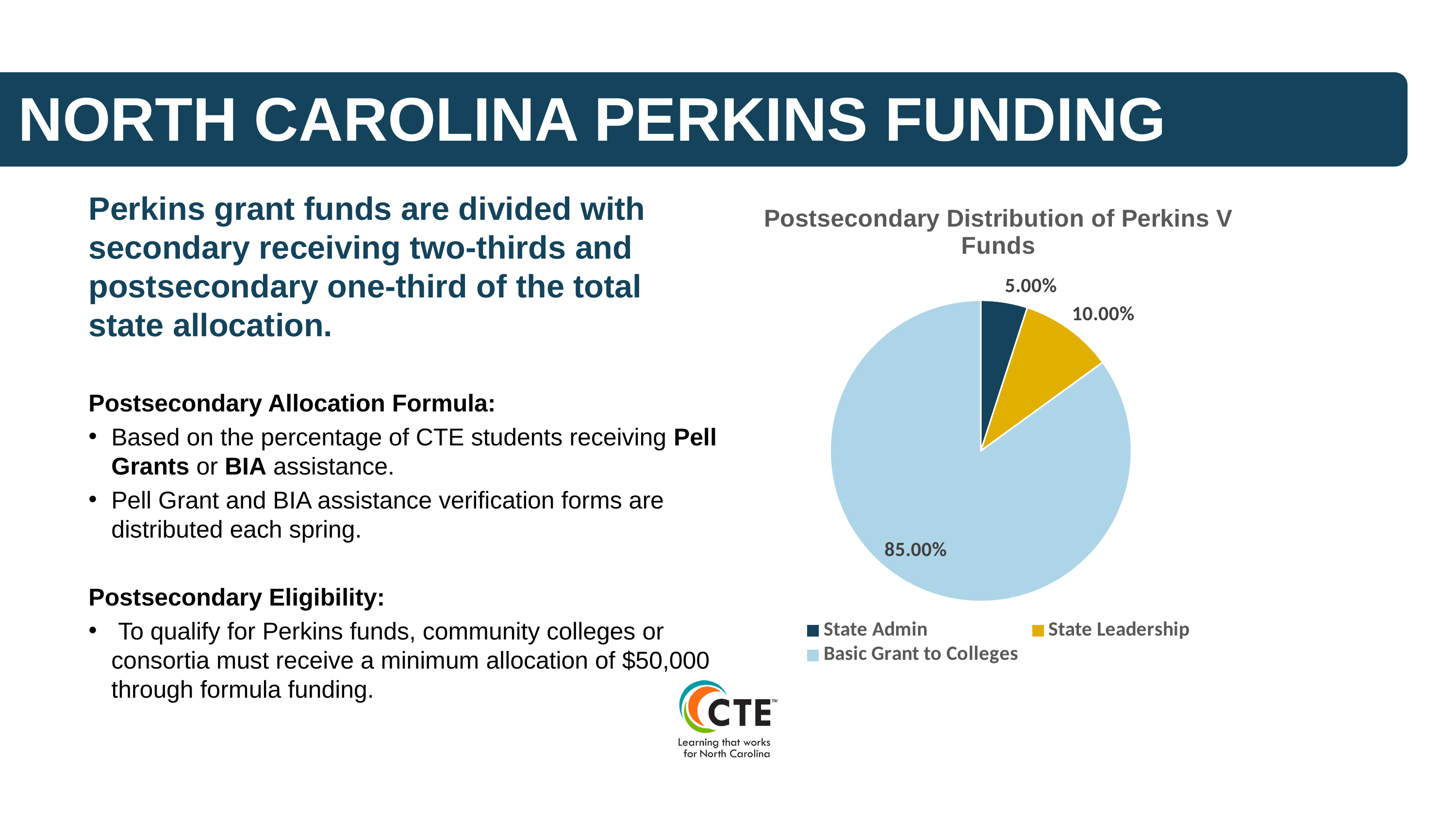
How many slices does the pie chart have? 3 Which is larger, the share for State Leadership or the share for State Admin? State Leadership Which category receives the largest share of Perkins V funds? Basic Grant to Colleges What is the title of the chart? Postsecondary Distribution of Perkins V Funds How many entries does the legend list? 3 What is the difference between the State Leadership share and the State Admin share? 5.00% Which category receives the smallest share of Perkins V funds? State Admin What share of Perkins V funds goes to State Admin? 5.00% What share of Perkins V funds goes to Basic Grant to Colleges? 85.00% What type of chart is shown on the slide? pie chart What share of Perkins V funds goes to State Leadership? 10.00% What colour is the Basic Grant to Colleges slice? light blue